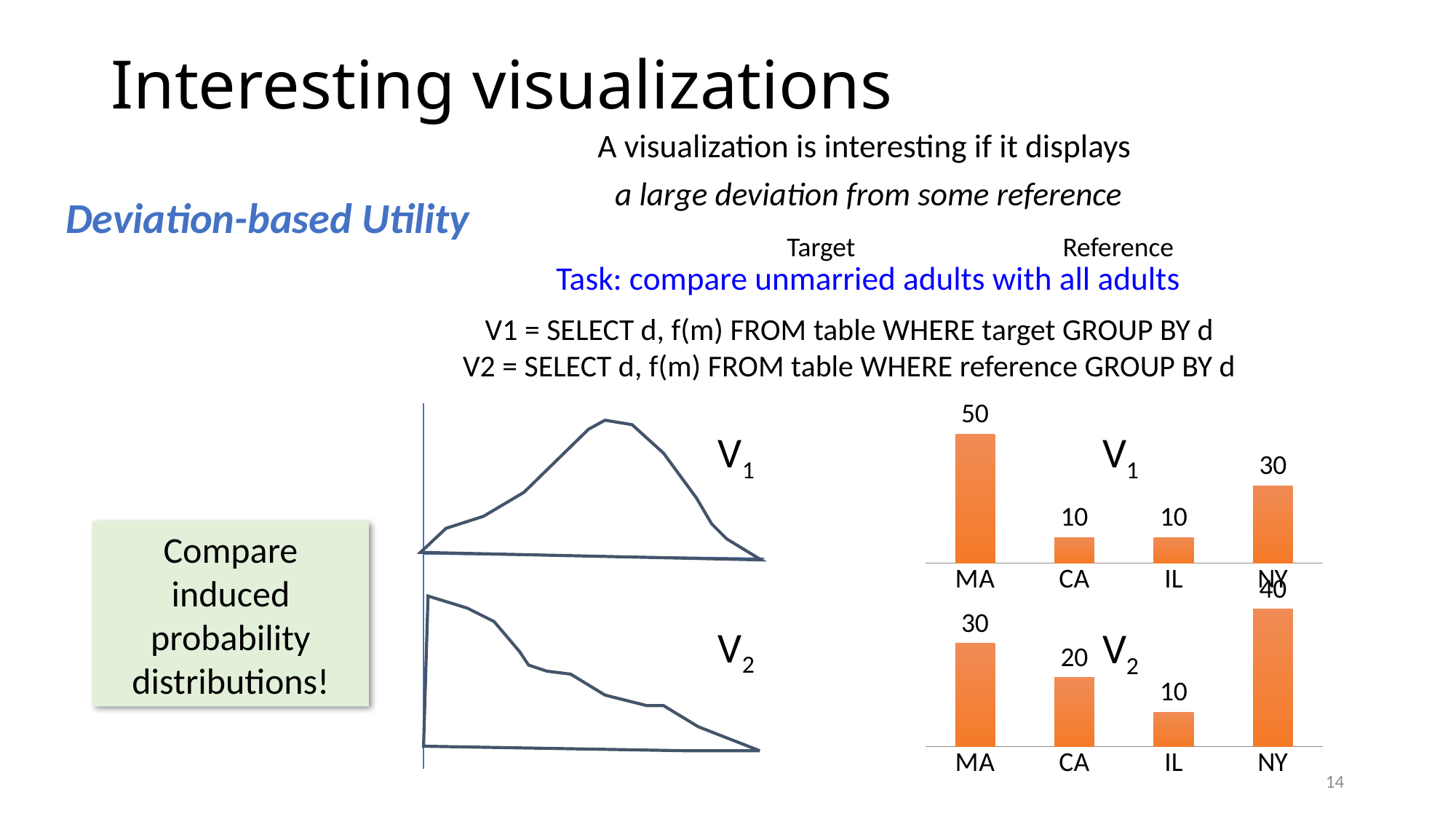
In the V2 bar chart, which is larger, the value for MA or the value for CA? MA In the V1 bar chart, what is the difference between the values for MA and NY? 20 How many categories does the V1 bar chart show? 4 In the V2 bar chart, which category has the lowest value? IL In the V2 bar chart, what is the value for CA? 20 In the V2 bar chart, what is the difference between the values for NY and MA? 10 In the V1 bar chart, which category has the highest value? MA In the V1 bar chart, what is the value for NY? 30 In the V2 bar chart, what is the value for NY? 40 What type of chart is V1 on the right side of the slide? bar chart In the V1 bar chart, what is the value for MA? 50 In the V2 bar chart, which category has the highest value? NY